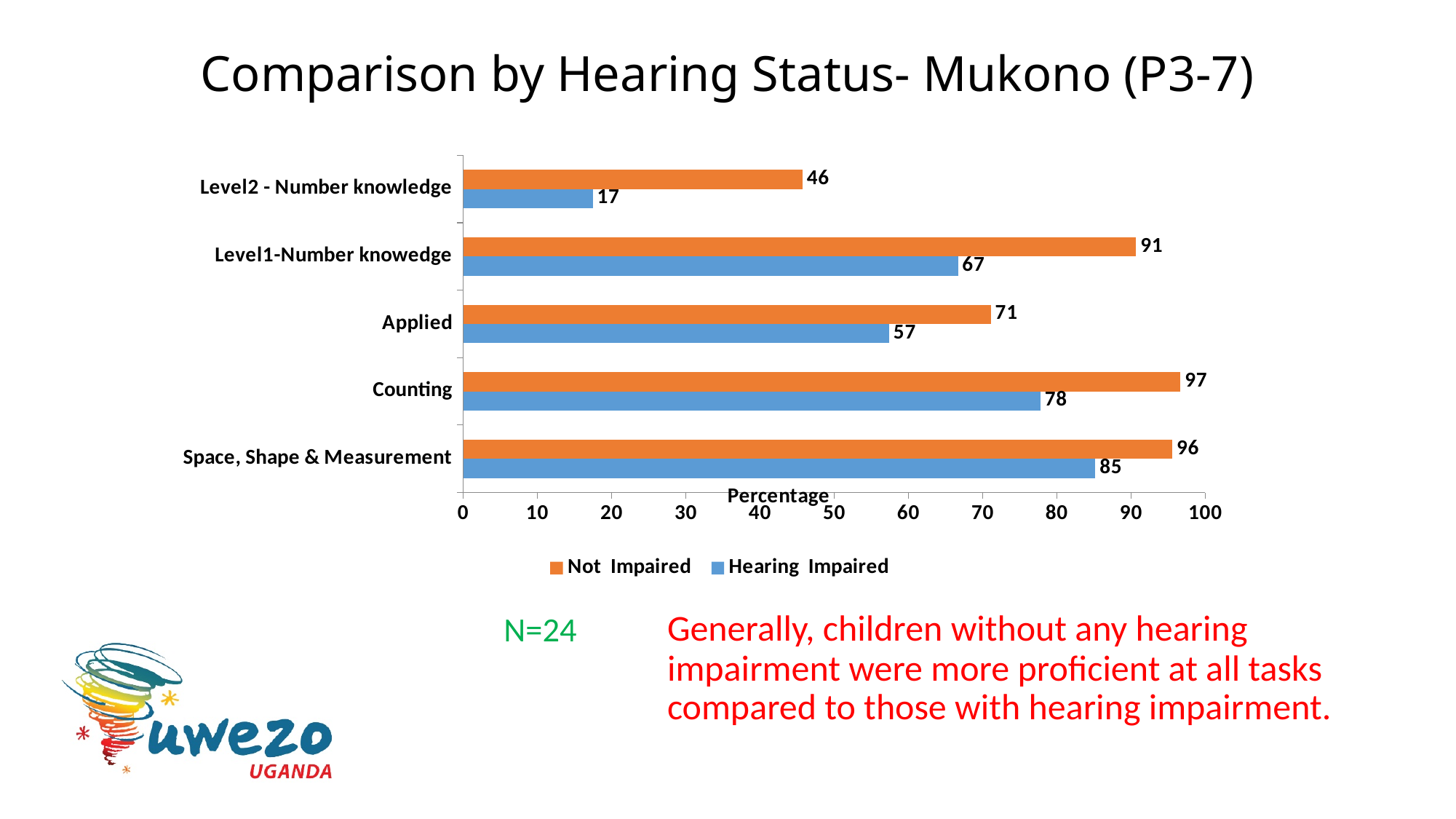
Which colour represents the Hearing Impaired series? Blue What kind of chart is shown on the slide? Bar chart What is the value for Not Impaired in the Counting category? 97 How many series does the legend list? 2 Which category has the highest Not Impaired value? Counting Which is larger: the Hearing Impaired value for Counting or the Hearing Impaired value for Space, Shape & Measurement? Space, Shape & Measurement What is the value for Hearing Impaired in the Applied category? 57 Which category has the lowest Hearing Impaired value? Level2 - Number knowledge How many categories are shown on the chart? 5 What is the value for Hearing Impaired in the Level2 - Number knowledge category? 17 What is the title of the chart's horizontal axis? Percentage What is the difference between the Not Impaired and Hearing Impaired values for Level1-Number knowedge? 24